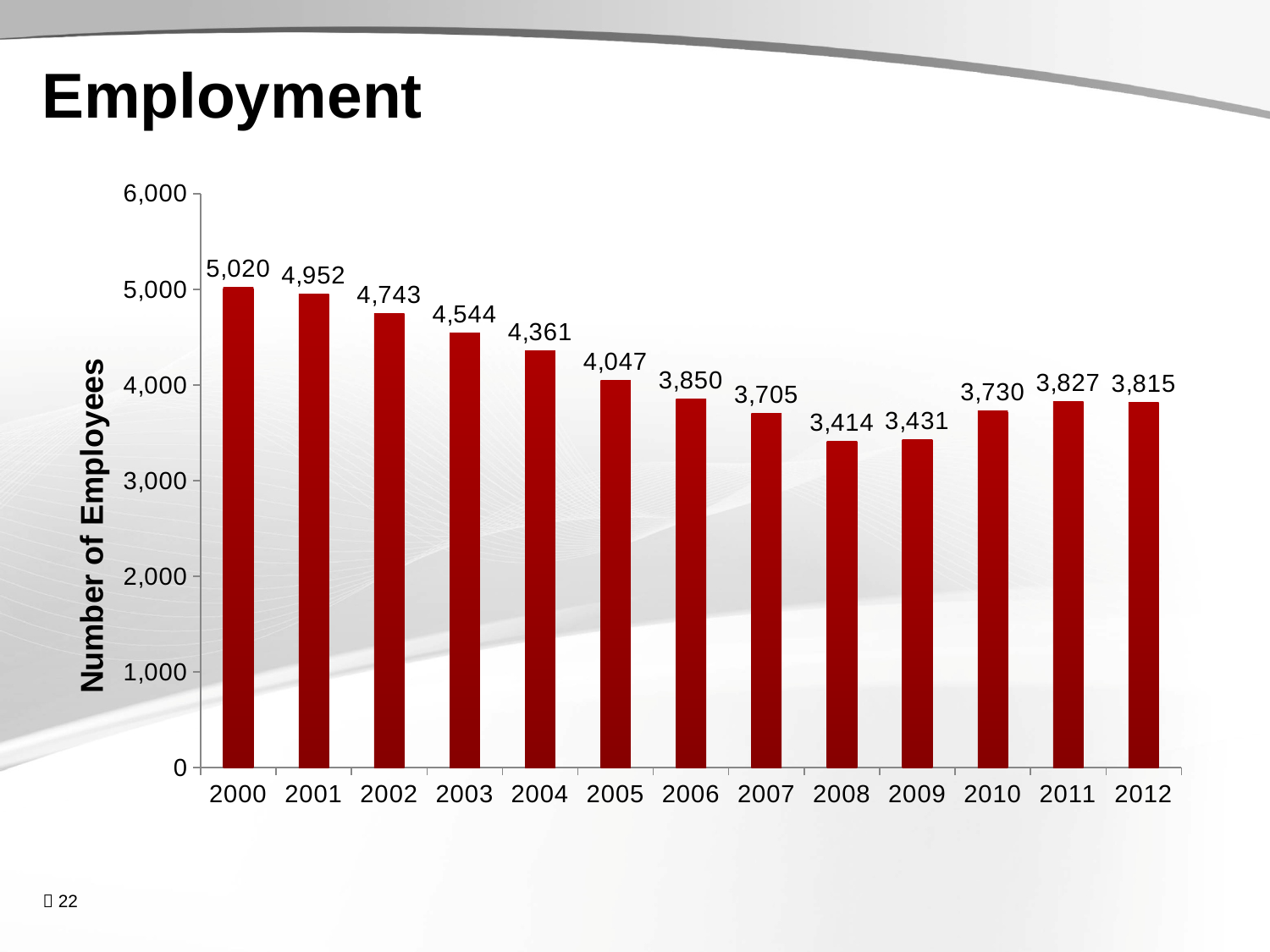
How many years are shown on the chart? 13 Which year has the lowest number of employees? 2008 What is the difference in the number of employees between 2005 and 2006? 197 What is the number of employees in 2000? 5,020 What is the number of employees in 2012? 3,815 What is the label of the vertical axis? Number of Employees Is the number of employees in 2003 greater or less than 4,000? greater What is the number of employees in 2008? 3,414 Which year has more employees, 2011 or 2010? 2011 Which year has the highest number of employees? 2000 What is the difference in the number of employees between 2000 and 2012? 1,205 What kind of chart is shown on the slide? bar chart